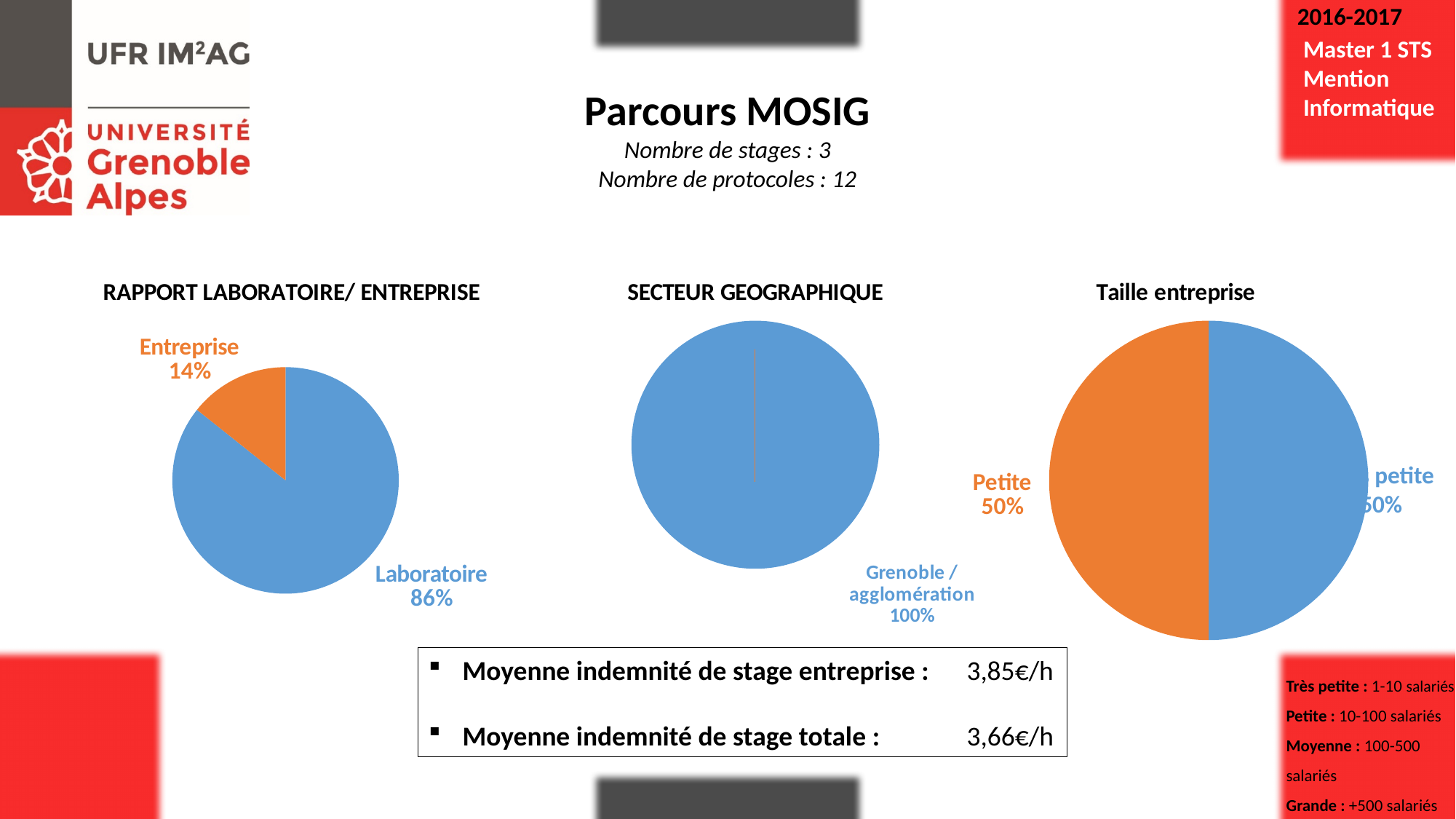
In the 'RAPPORT LABORATOIRE/ ENTREPRISE' chart, what colour is the Entreprise slice? Orange What kind of chart is the 'SECTEUR GEOGRAPHIQUE' chart? Pie chart In the 'RAPPORT LABORATOIRE/ ENTREPRISE' chart, what is the difference in percentage points between Laboratoire and Entreprise? 72 In the 'RAPPORT LABORATOIRE/ ENTREPRISE' chart, what share is Entreprise? 14% In the 'Taille entreprise' chart, what share is Petite? 50% In the 'RAPPORT LABORATOIRE/ ENTREPRISE' chart, which category has the largest slice? Laboratoire In the 'RAPPORT LABORATOIRE/ ENTREPRISE' chart, what share is Laboratoire? 86% In the 'RAPPORT LABORATOIRE/ ENTREPRISE' chart, which category has the smallest slice? Entreprise In the 'SECTEUR GEOGRAPHIQUE' chart, how many categories are shown? 1 In the 'Taille entreprise' chart, how many slices does the pie have? 2 In the 'RAPPORT LABORATOIRE/ ENTREPRISE' chart, how many slices does the pie have? 2